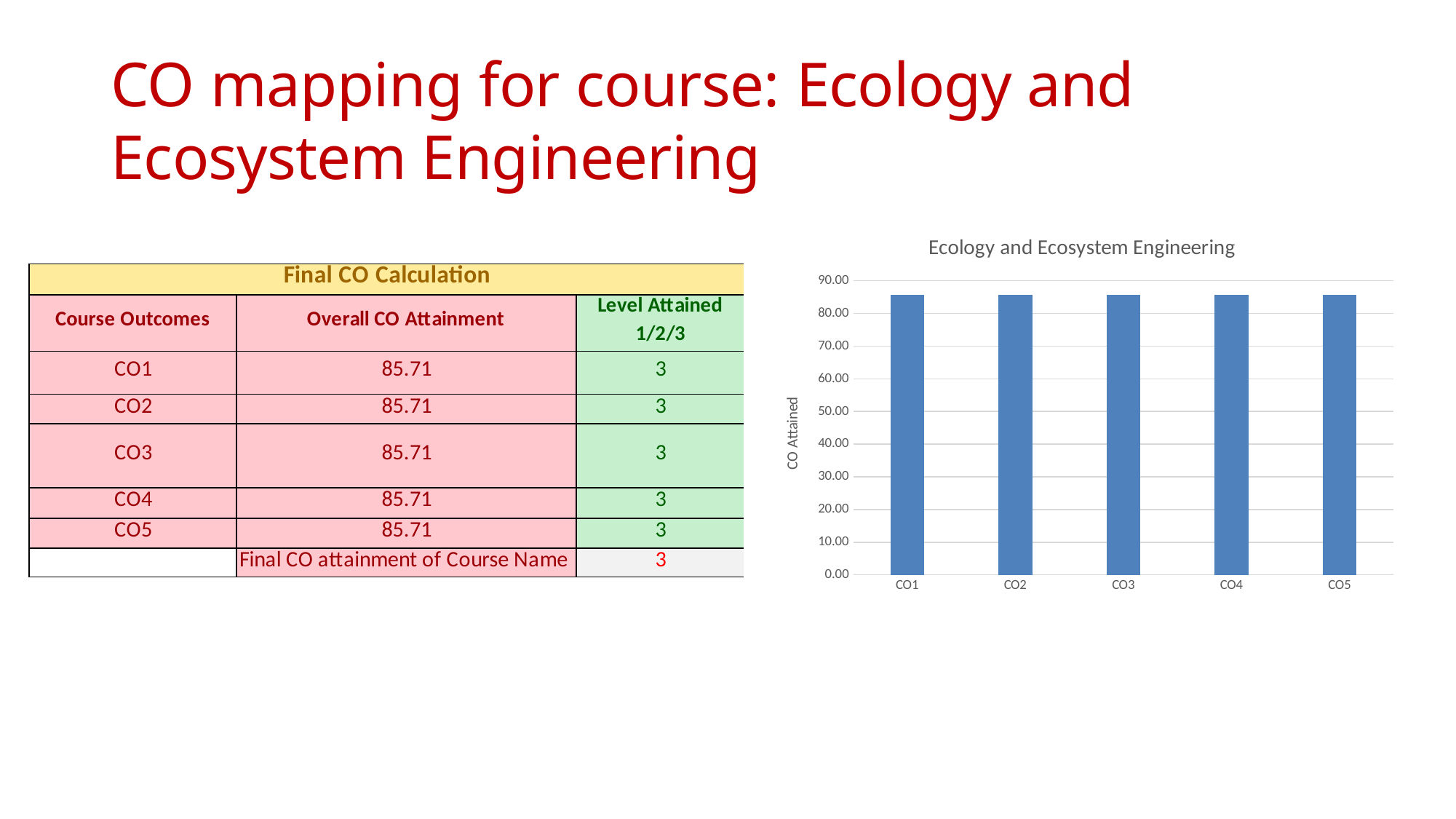
What is the title of the chart? Ecology and Ecosystem Engineering What kind of chart is shown on the slide? bar chart Is the value for CO2 greater or less than 50.00? greater How many categories are plotted on the x axis of the chart? 5 What is the label of the vertical axis of the chart? CO Attained What is the highest tick value shown on the vertical axis of the chart? 90.00 Is the value for CO5 greater or less than 70.00? greater Is the value for CO4 greater or less than 90.00? less Do the bar values rise, fall, or stay flat from CO1 to CO5? stay flat